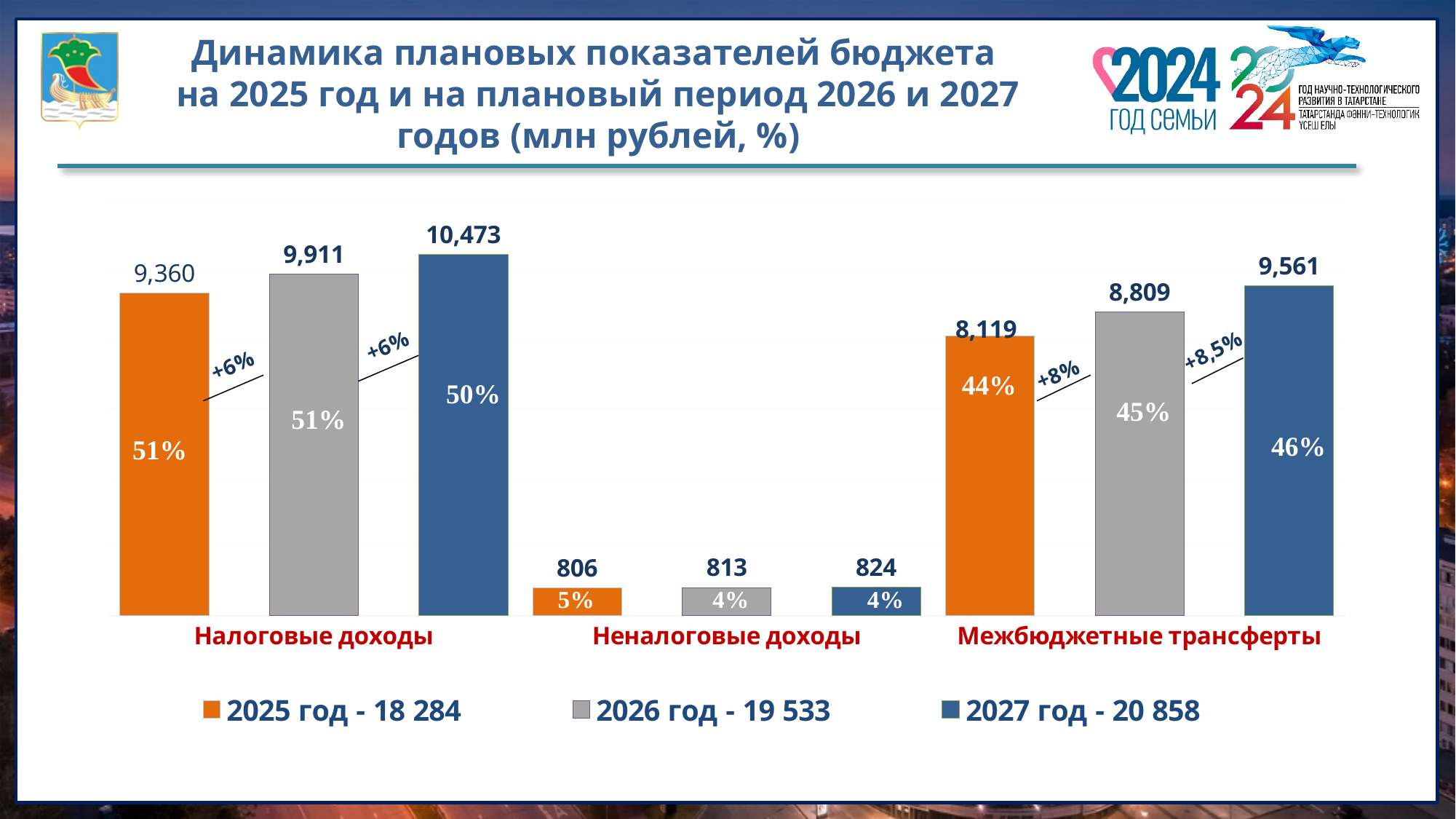
What is the value for Налоговые доходы in the 2025 год series? 9,360 What kind of chart is shown on the slide? Bar chart Which category has the highest value in the 2027 год series? Налоговые доходы How many categories are shown on the x axis? 3 How many series does the legend list? 3 What is the value for Неналоговые доходы in the 2026 год series? 813 What is the difference between the 2027 год and 2025 год values for Межбюджетные трансферты? 1,442 What is the difference between the 2027 год and 2025 год values for Налоговые доходы? 1,113 Which is larger: the 2026 год value for Налоговые доходы or the 2026 год value for Межбюджетные трансферты? Налоговые доходы What is the value for Межбюджетные трансферты in the 2027 год series? 9,561 Which category has the lowest value in the 2025 год series? Неналоговые доходы What percentage is shown inside the 2025 год bar for Межбюджетные трансферты? 44%